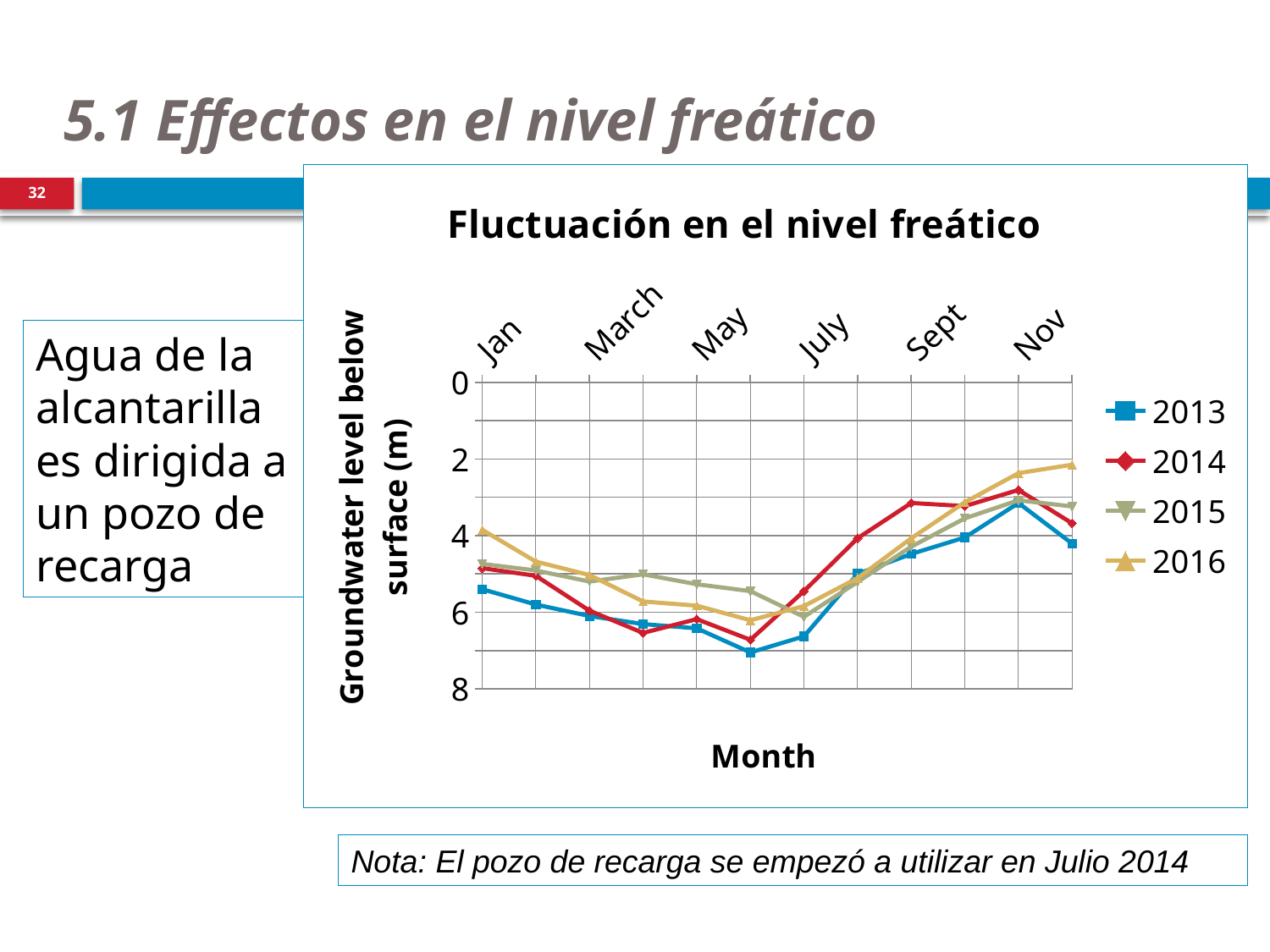
What is the title of the chart? Fluctuación en el nivel freático Is the value for 2016 at the last point (Dec) greater or less than 4? less What kind of chart is shown on the slide? line chart How many series does the legend list? 4 Which series has the lowest groundwater level below surface value at the last point (Dec)? 2016 How many month labels are printed along the x axis? 6 What is the label of the vertical axis? Groundwater level below surface (m) Is the value for 2015 in March greater or less than 4? greater Is the value for 2014 in Sept greater or less than 4? less In March, which series has the larger value, 2014 or 2015? 2014 Which series has the lowest value in Jan? 2016